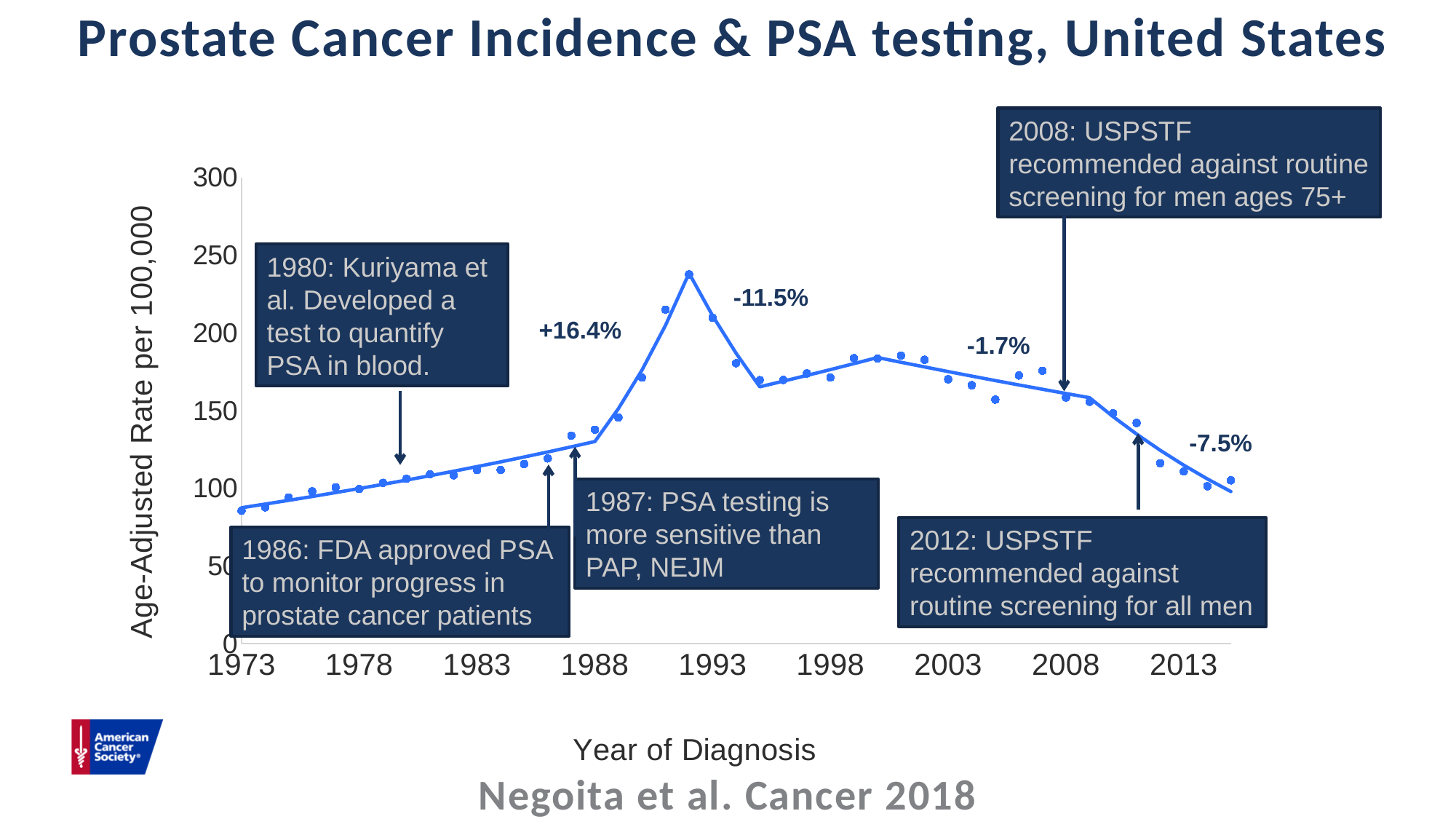
What percentage change is printed above the line between about 2000 and 2008? -1.7% What percentage change is printed next to the sharp drop right after the peak? -11.5% Is the age-adjusted rate for 1973 greater or less than 100? less Is the age-adjusted rate for 2013 greater or less than 150? less Does the age-adjusted rate rise or fall between 1973 and 1988? rise What percentage change is printed next to the final segment of the line after 2010? -7.5% What percentage change is printed above the steep rise in the line just before the peak? +16.4% What is the title of the chart? Prostate Cancer Incidence & PSA testing, United States What is the label on the y axis of the chart? Age-Adjusted Rate per 100,000 Is the peak age-adjusted rate on the chart greater or less than 200? greater Does the age-adjusted rate rise or fall between 2008 and 2013? fall What kind of chart is shown on the slide? line chart